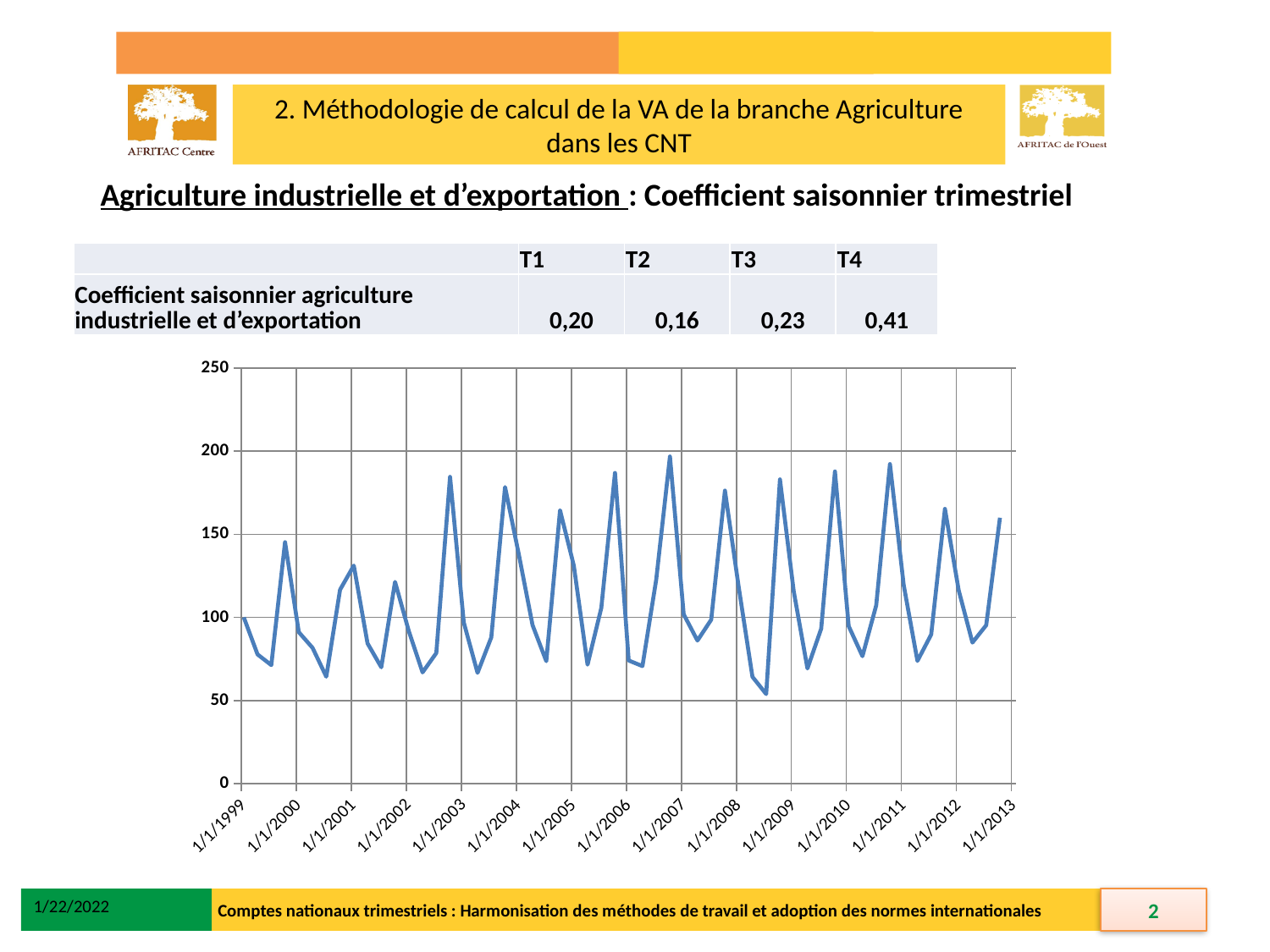
Does the line ever rise above 150 on the chart? yes Does the line ever fall below 100 on the chart? yes What is the last date label on the x axis of the chart? 1/1/2013 What is the first date label on the x axis of the chart? 1/1/1999 Does the line ever rise above 250 on the chart? no Does the line follow a steady upward trend, a steady downward trend, or a repeating up-and-down (seasonal) pattern along the x axis? repeating up-and-down (seasonal) pattern How many date labels are shown on the x axis of the chart? 15 What kind of chart is shown on the slide? line chart How many lines (series) are plotted on the chart? 1 What is the highest value shown on the y axis of the chart? 250